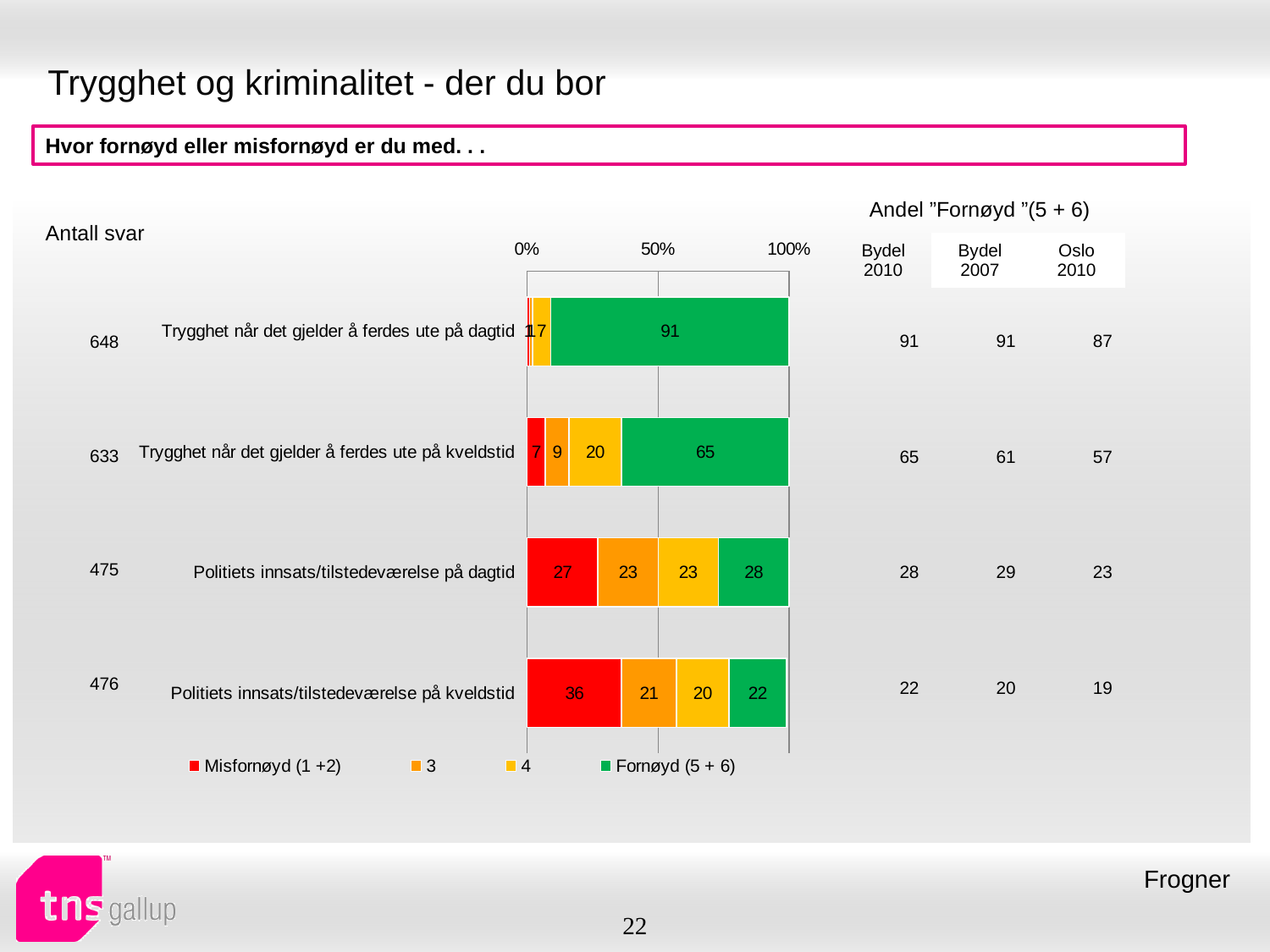
Which category has the lowest Fornøyd (5 + 6) value? Politiets innsats/tilstedeværelse på kveldstid What is the Fornøyd (5 + 6) value for 'Trygghet når det gjelder å ferdes ute på dagtid'? 91 What is the value of series '4' for 'Trygghet når det gjelder å ferdes ute på kveldstid'? 20 What type of chart is shown on the slide? Stacked bar chart How many categories are plotted in the chart? 4 What is the Misfornøyd (1 +2) value for 'Politiets innsats/tilstedeværelse på kveldstid'? 36 How many series does the chart legend list? 4 What colour represents the Fornøyd (5 + 6) series in the chart? Green What is the difference between the Fornøyd (5 + 6) values for 'Trygghet når det gjelder å ferdes ute på dagtid' and 'Trygghet når det gjelder å ferdes ute på kveldstid'? 26 Which category has the highest Fornøyd (5 + 6) value? Trygghet når det gjelder å ferdes ute på dagtid Which is larger: the Misfornøyd (1 +2) value for 'Politiets innsats/tilstedeværelse på dagtid' or for 'Politiets innsats/tilstedeværelse på kveldstid'? Politiets innsats/tilstedeværelse på kveldstid What is the value of series '3' for 'Politiets innsats/tilstedeværelse på dagtid'? 23